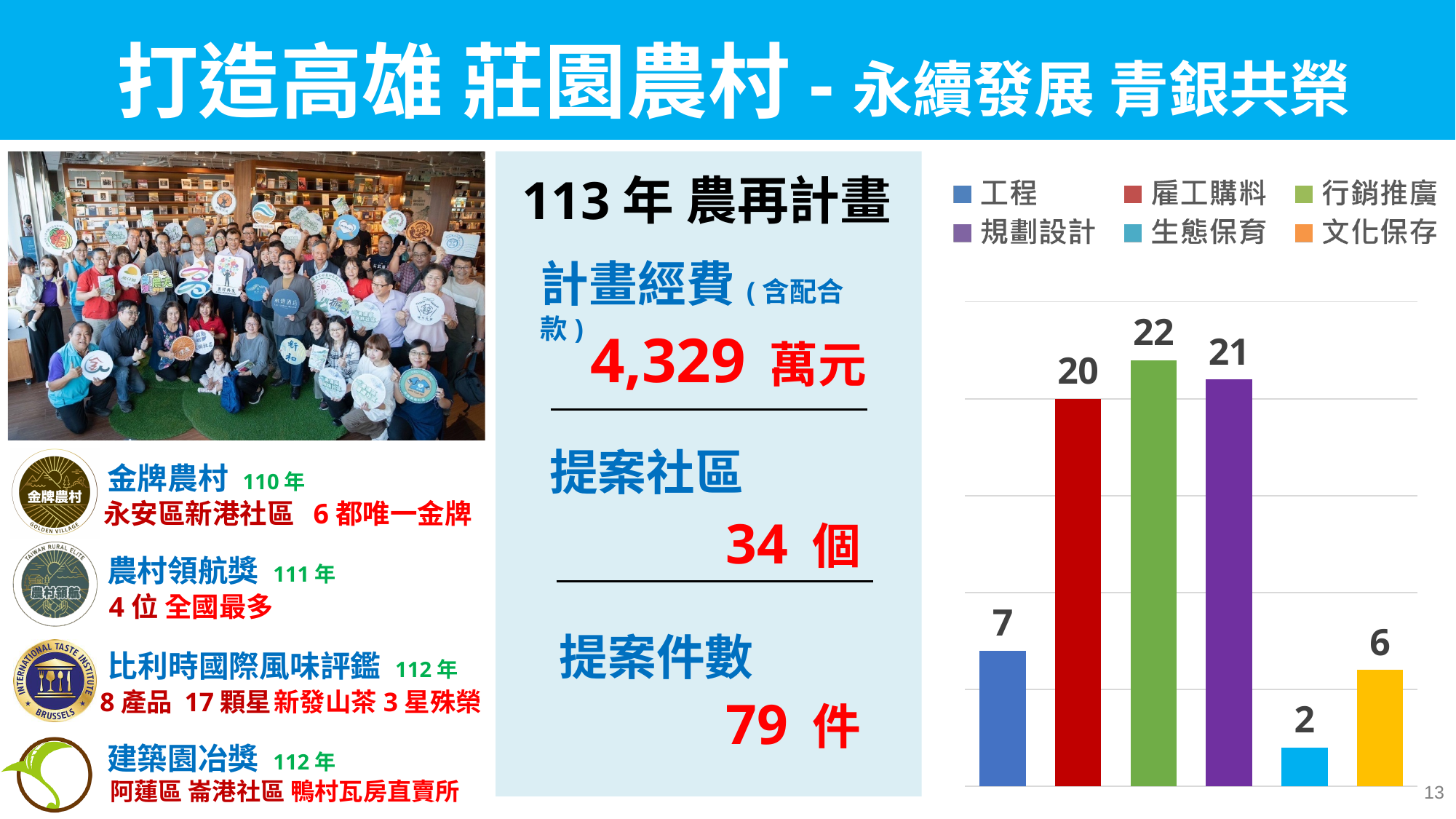
What is the difference between the values for 行銷推廣 and 工程 in the bar chart? 15 What is the value for 雇工購料 in the bar chart? 20 Which category has the highest value in the bar chart? 行銷推廣 What is the value for 行銷推廣 in the bar chart? 22 What kind of chart is shown on the right of the slide? bar chart What is the value for 生態保育 in the bar chart? 2 What is the value for 文化保存 in the bar chart? 6 Which category has the lowest value in the bar chart? 生態保育 What is the value for 工程 in the bar chart? 7 Which is larger in the bar chart, 雇工購料 or 文化保存? 雇工購料 How many series does the legend of the bar chart list? 6 What is the value for 規劃設計 in the bar chart? 21